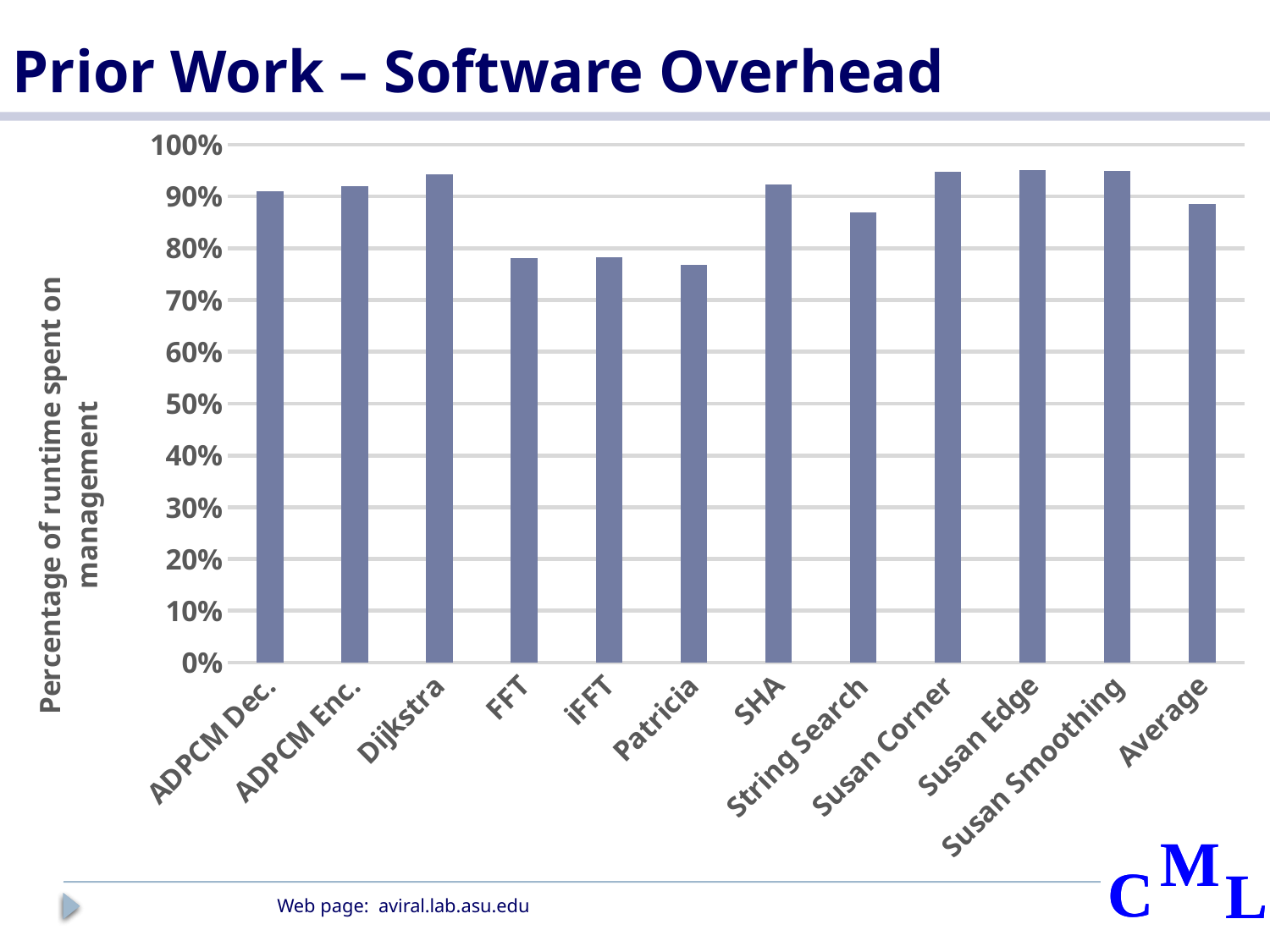
What is the label on the vertical axis of the chart? Percentage of runtime spent on management What kind of chart is shown on the slide? bar chart How many categories are plotted along the x axis? 12 Which has the larger value, Dijkstra or FFT? Dijkstra Is the value for Dijkstra greater or less than 90%? greater Which has the larger value, Patricia or Average? Average Is the value for FFT greater or less than 80%? less Is the value for Average greater or less than 90%? less Which has the larger value, String Search or Susan Corner? Susan Corner